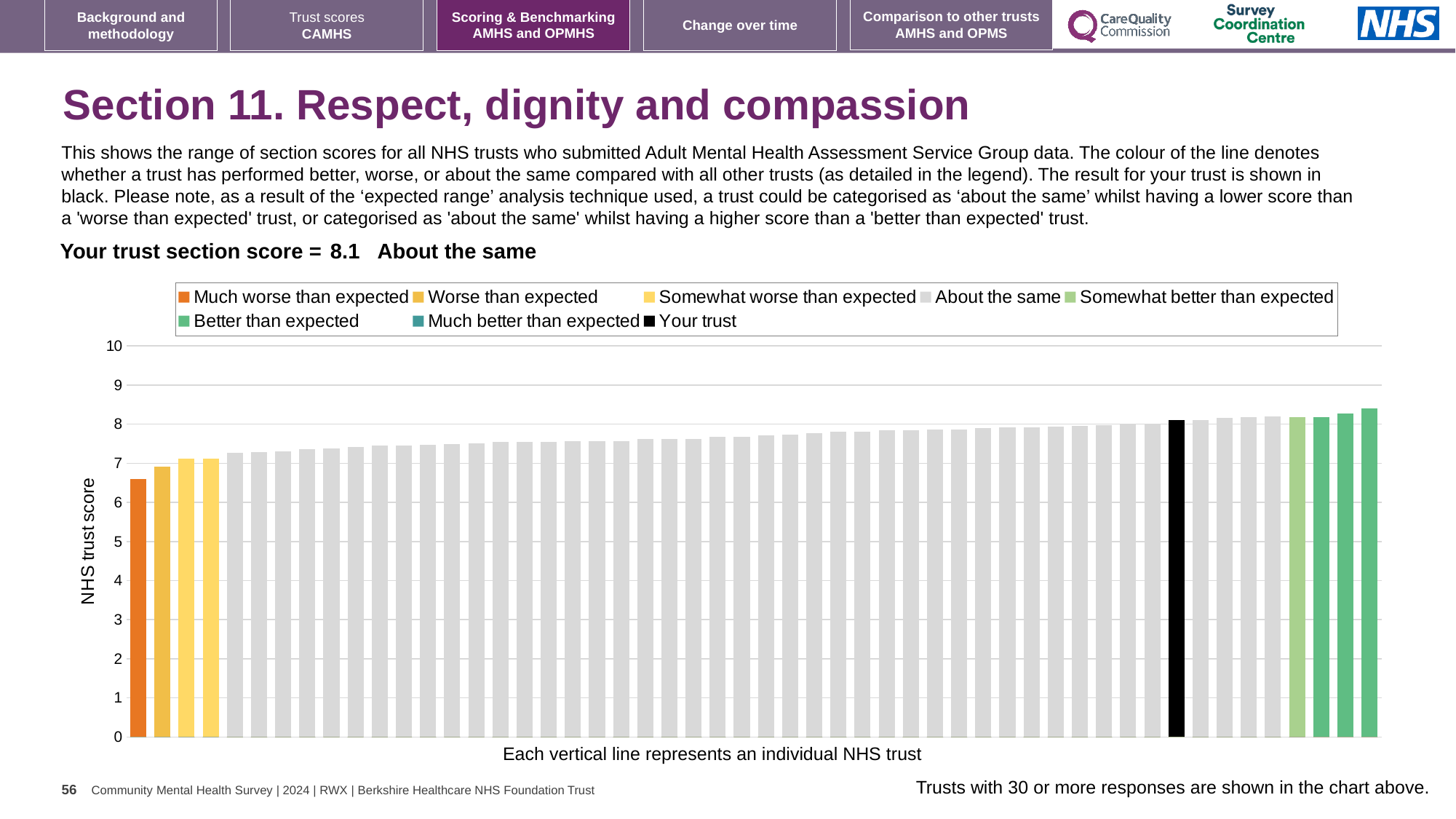
How many bars are coloured orange (Much worse than expected)? 1 How many entries does the chart legend list? 8 Is the value for the rightmost bar greater or less than 8? greater Which is larger: the value of the black 'Your trust' bar or the orange 'Much worse than expected' bar? Your trust Is the value for the orange 'Much worse than expected' bar greater or less than 7? less What is the label on the y axis of the chart? NHS trust score Is the value for the black 'Your trust' bar greater or less than 8? greater What kind of chart is shown on the slide? Bar chart Do the bar values rise or fall from left to right along the x axis? rise What is the section score for your trust? 8.1 How many bars are coloured in the 'Better than expected' green shade? 3 What colour is used for the 'Your trust' bar in the chart? Black